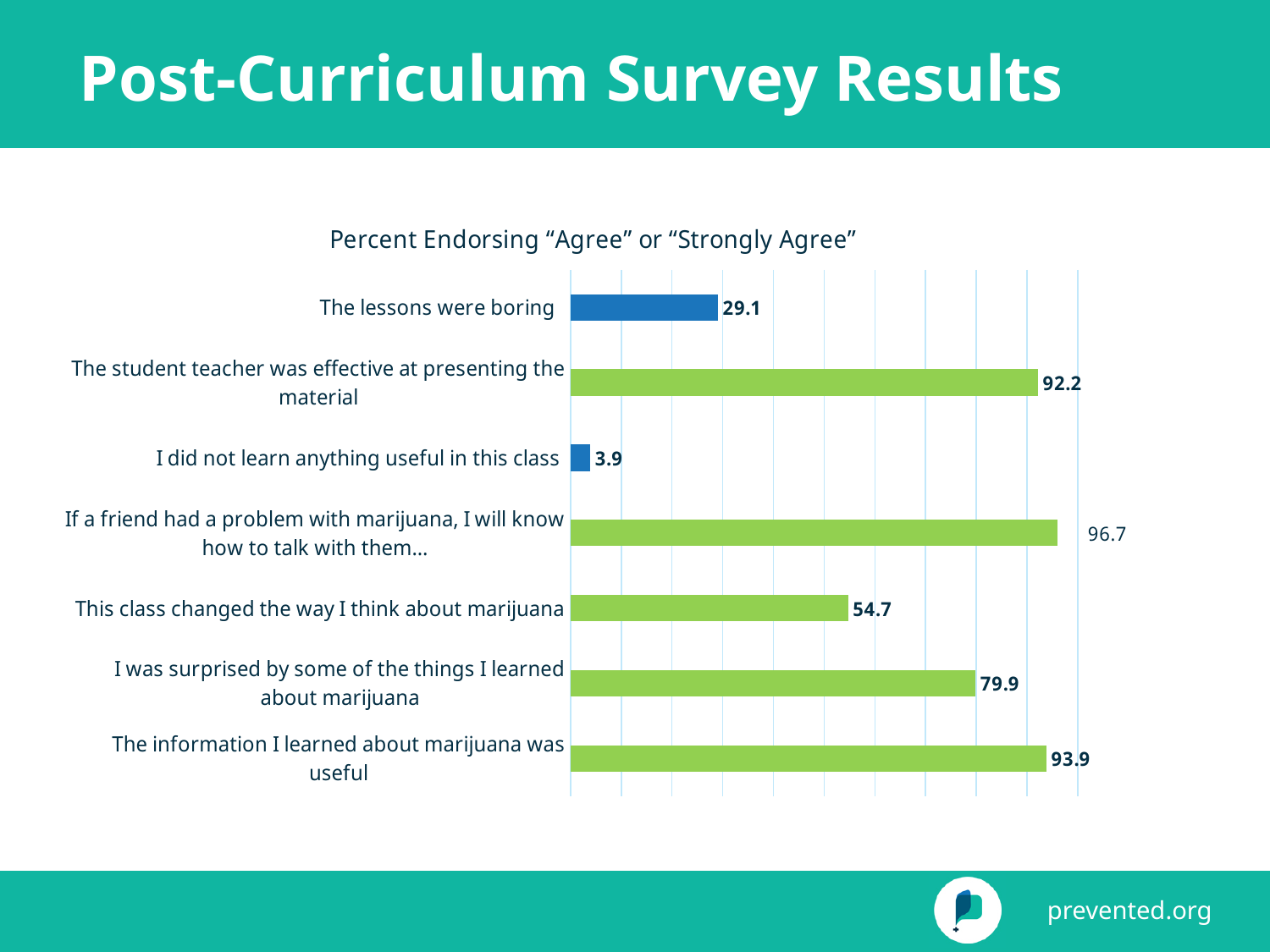
What is the difference between the values for "The information I learned about marijuana was useful" and "The lessons were boring"? 64.8 What is the value for "The student teacher was effective at presenting the material"? 92.2 What percent endorsed "Agree" or "Strongly Agree" for "The lessons were boring"? 29.1 Which is larger: the value for "The student teacher was effective at presenting the material" or "I was surprised by some of the things I learned about marijuana"? The student teacher was effective at presenting the material Which statement has the highest percent endorsing "Agree" or "Strongly Agree"? If a friend had a problem with marijuana, I will know how to talk with them... What is the value for "I was surprised by some of the things I learned about marijuana"? 79.9 How many statements are shown in the chart? 7 What is the value for "I did not learn anything useful in this class"? 3.9 What is the title of the chart? Percent Endorsing "Agree" or "Strongly Agree" Which statement has the lowest value? I did not learn anything useful in this class What is the value for "This class changed the way I think about marijuana"? 54.7 What kind of chart is shown on the slide? Bar chart